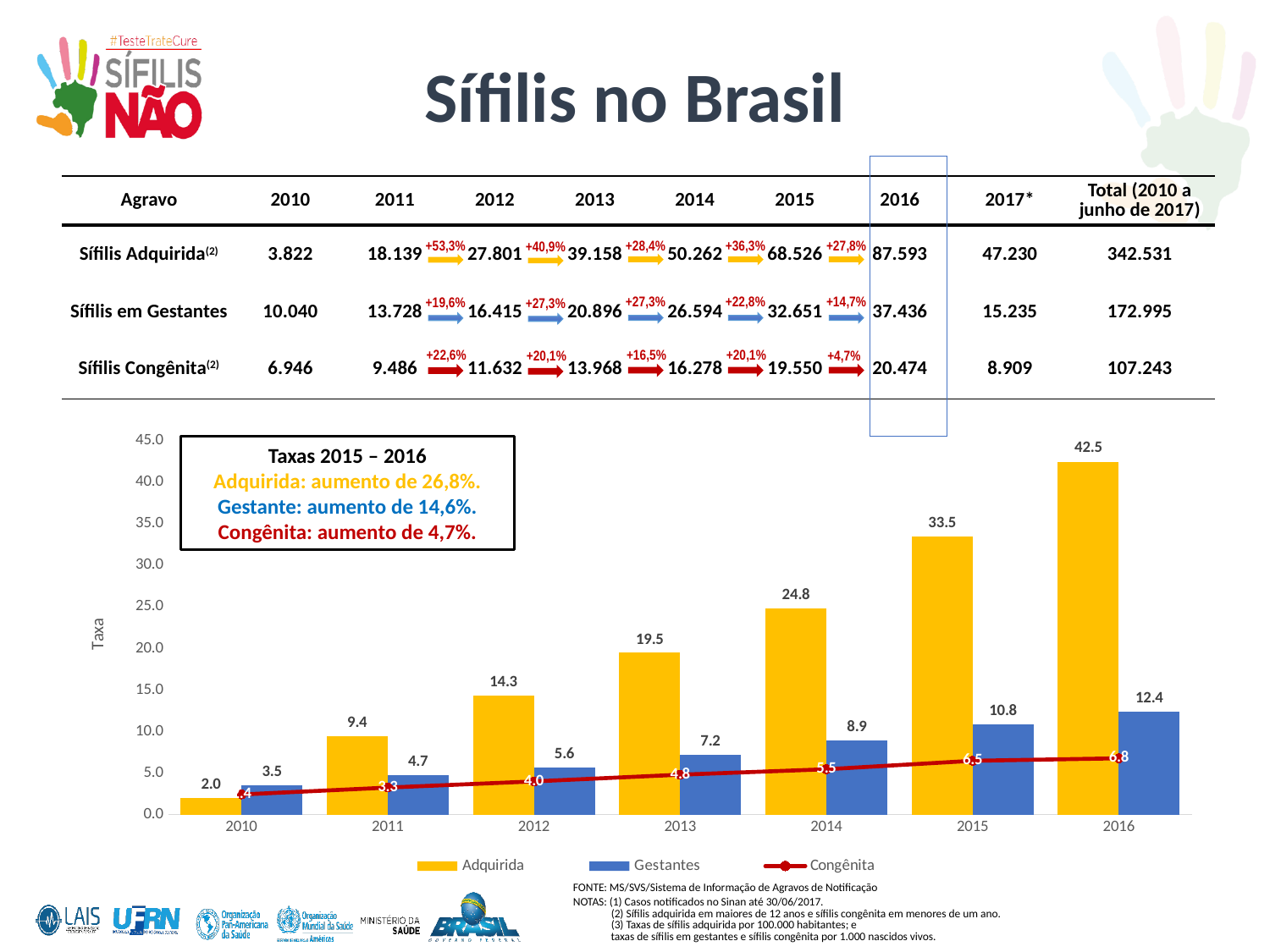
Is the Adquirida rate for 2014 greater or less than 20.0? greater What is the Adquirida rate for 2016 in the chart? 42.5 Which year has the highest Adquirida rate in the chart? 2016 How many years are shown on the x axis of the chart? 7 Does the Adquirida rate rise or fall from 2010 to 2016? rise Which is larger in 2013: the Adquirida rate or the Gestantes rate? Adquirida Which year has the lowest Gestantes rate in the chart? 2010 What is the Gestantes rate for 2014 in the chart? 8.9 Which series is drawn as a red line in the chart? Congênita How many series does the chart legend list? 3 What is the difference between the Adquirida rates for 2016 and 2015? 9.0 What is the Congênita rate for 2015 in the chart? 6.5